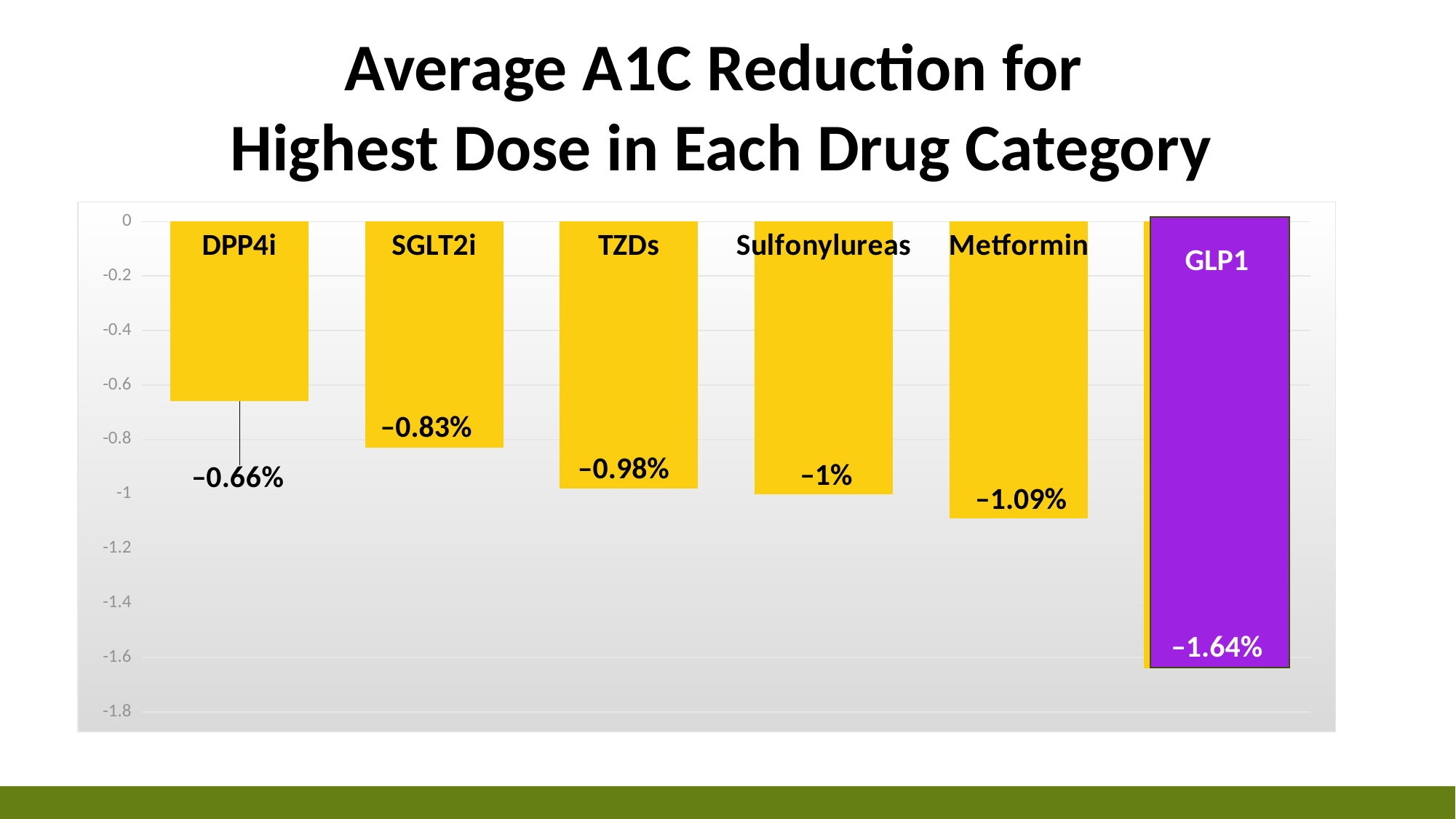
How many drug categories are shown in the chart? 6 Which bar is coloured purple rather than yellow? GLP1 Which drug category shows the largest A1C reduction? GLP1 Which has a larger A1C reduction, TZDs or SGLT2i? TZDs What type of chart is shown on the slide? Bar chart What is the average A1C reduction shown for Metformin? –1.09% Which drug category shows the smallest A1C reduction? DPP4i How much larger is the A1C reduction for GLP1 than for Metformin, in percentage points? 0.55 What is the average A1C reduction shown for Sulfonylureas? –1% What is the average A1C reduction shown for GLP1? –1.64% What is the average A1C reduction shown for DPP4i? –0.66% How much larger is the A1C reduction for SGLT2i than for DPP4i, in percentage points? 0.17